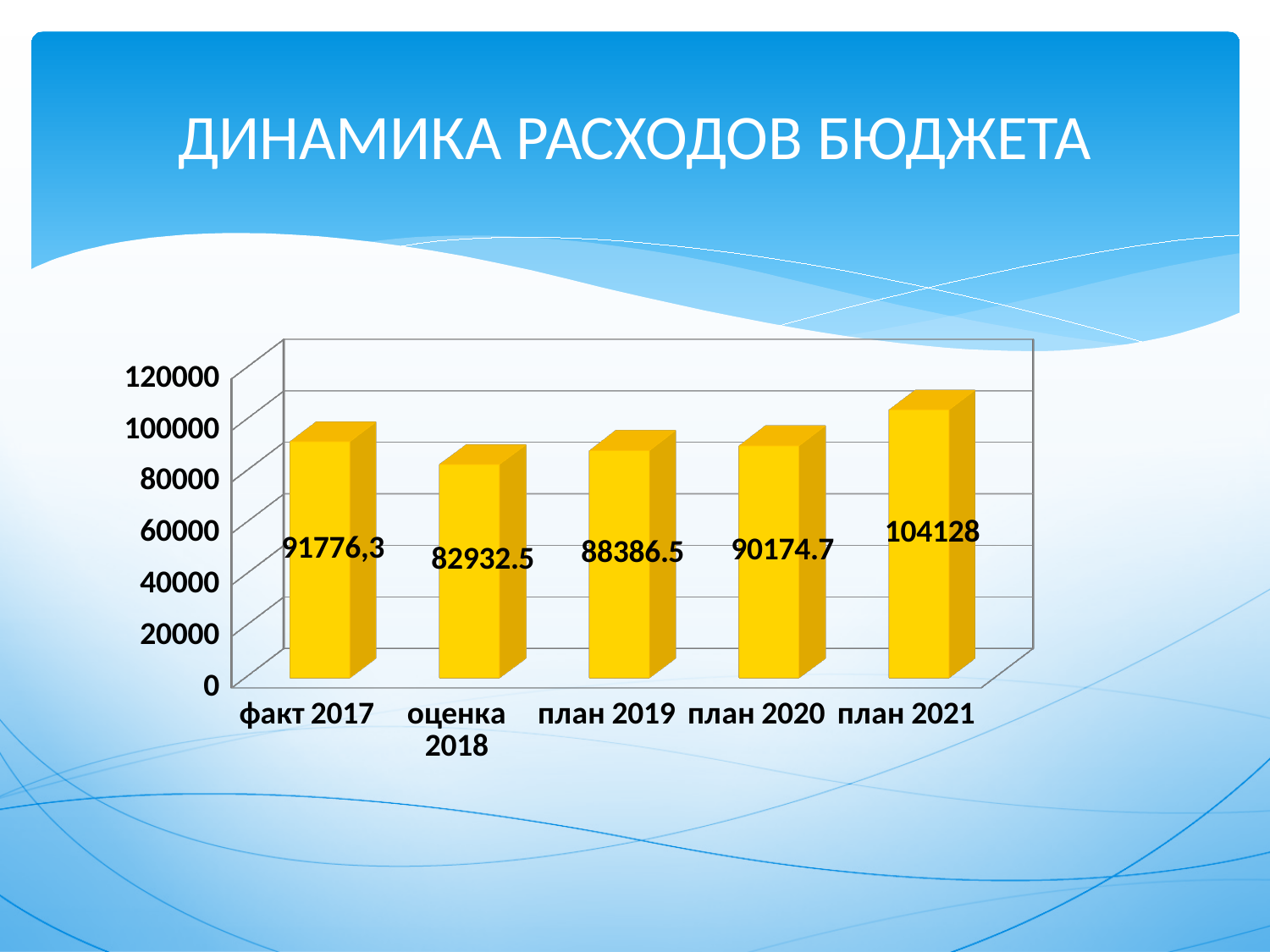
Which category has the highest value? план 2021 What is the difference between the values for план 2019 and оценка 2018? 5454 Is the value for план 2021 greater or less than 100000? greater What kind of chart is shown on the slide? bar chart What is the value for план 2021? 104128 Which is larger, the value for факт 2017 or the value for план 2020? факт 2017 How many categories are shown on the x axis? 5 Which category has the lowest value? оценка 2018 What is the difference between the values for план 2021 and план 2020? 13953.3 What is the value for оценка 2018? 82932.5 What is the value for факт 2017? 91776,3 What is the value for план 2019? 88386.5